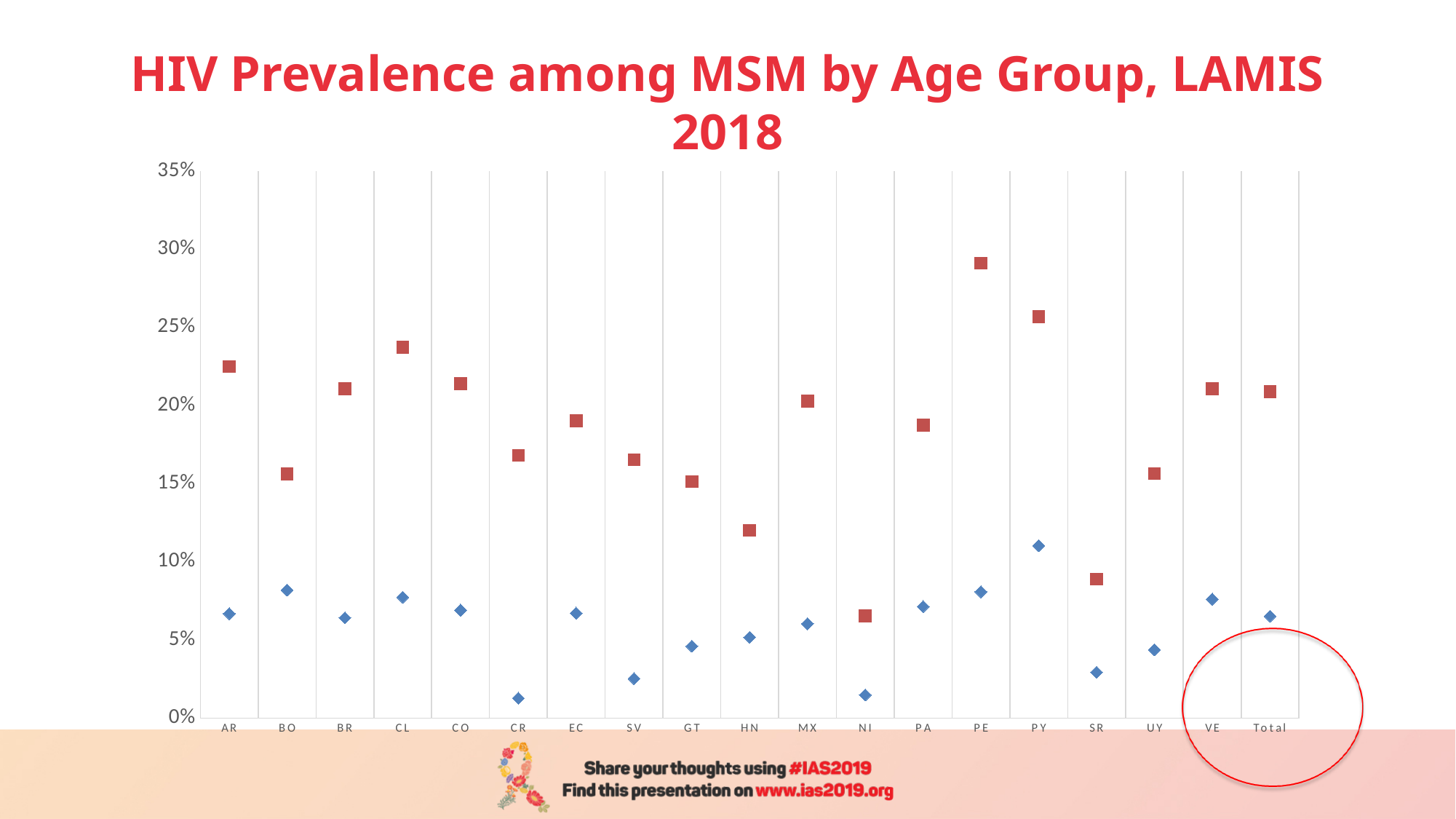
Which category has the lowest red square value? NI Is the red square value for HN greater or less than 15%? less Which category has the highest blue diamond value? PY What is the title of the chart? HIV Prevalence among MSM by Age Group, LAMIS 2018 Which category has the highest red square value? PE Which category on the x axis is circled in red on the slide? Total What kind of chart is shown on the slide? scatter chart Is the red square value for PE greater or less than 25%? greater Is the blue diamond value for CR greater or less than 5%? less How many categories are shown along the x axis of the chart? 19 Which has the larger red square value, CL or BO? CL